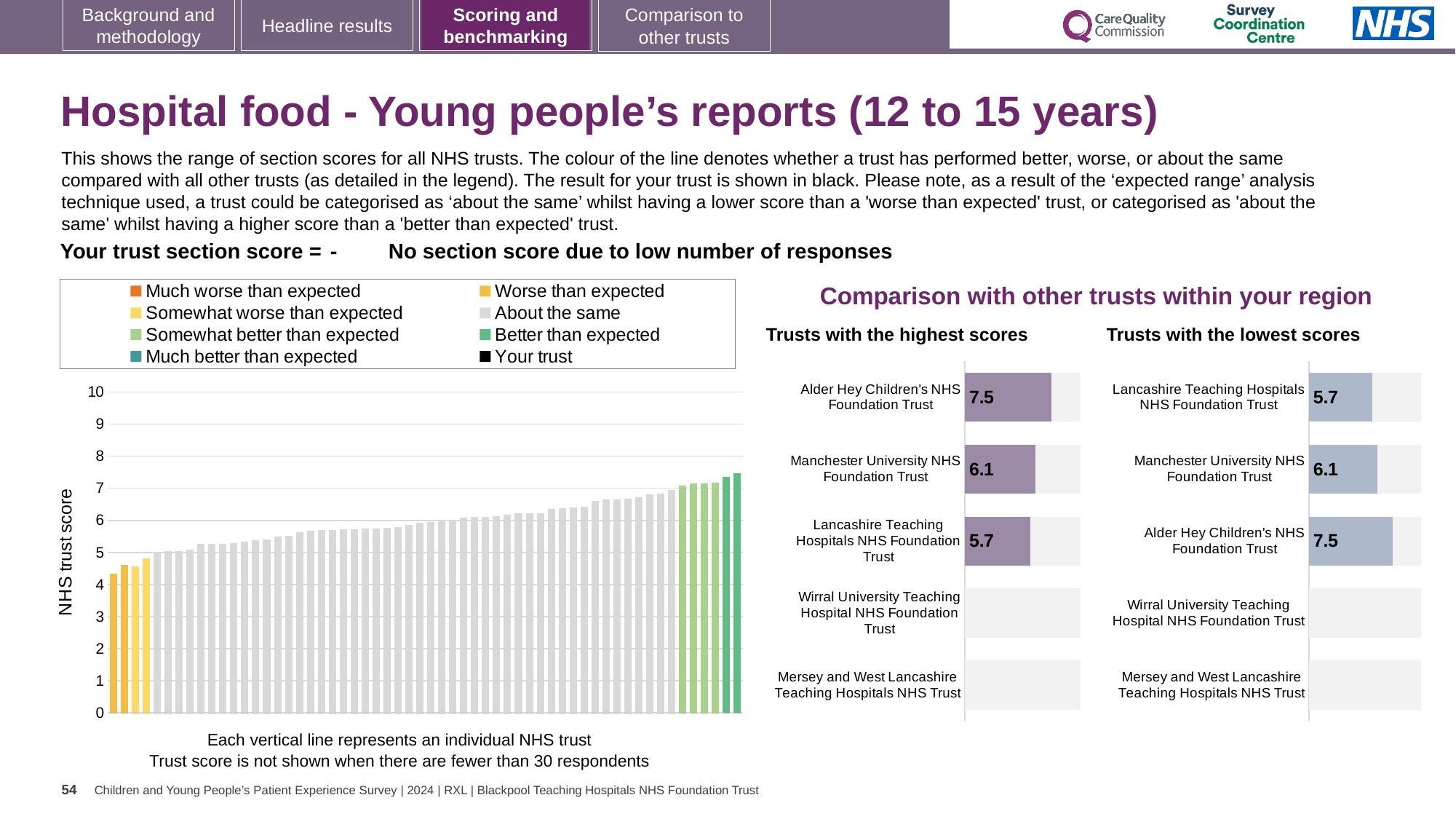
What is the label on the vertical axis of the large chart on the left? NHS trust score In the 'Trusts with the highest scores' chart, what is the score for Alder Hey Children's NHS Foundation Trust? 7.5 In the 'Trusts with the lowest scores' chart, what is the score for Lancashire Teaching Hospitals NHS Foundation Trust? 5.7 What kind of chart is the large chart on the left showing NHS trust scores? bar chart How many entries does the legend above the large chart on the left list? 8 In the large chart on the left, do the trust scores rise or fall from left to right? rise In the large chart on the left, is the value of the rightmost (tallest) bar greater or less than 7? greater In the 'Trusts with the highest scores' chart, what is the score for Manchester University NHS Foundation Trust? 6.1 In the 'Trusts with the lowest scores' chart, which trust has the lowest score? Lancashire Teaching Hospitals NHS Foundation Trust How many trusts are listed in the 'Trusts with the highest scores' chart? 5 In the 'Trusts with the highest scores' chart, what is the difference between the scores of Alder Hey Children's NHS Foundation Trust and Lancashire Teaching Hospitals NHS Foundation Trust? 1.8 In the large chart on the left, is the value of the leftmost (lowest) bar greater or less than 5? less